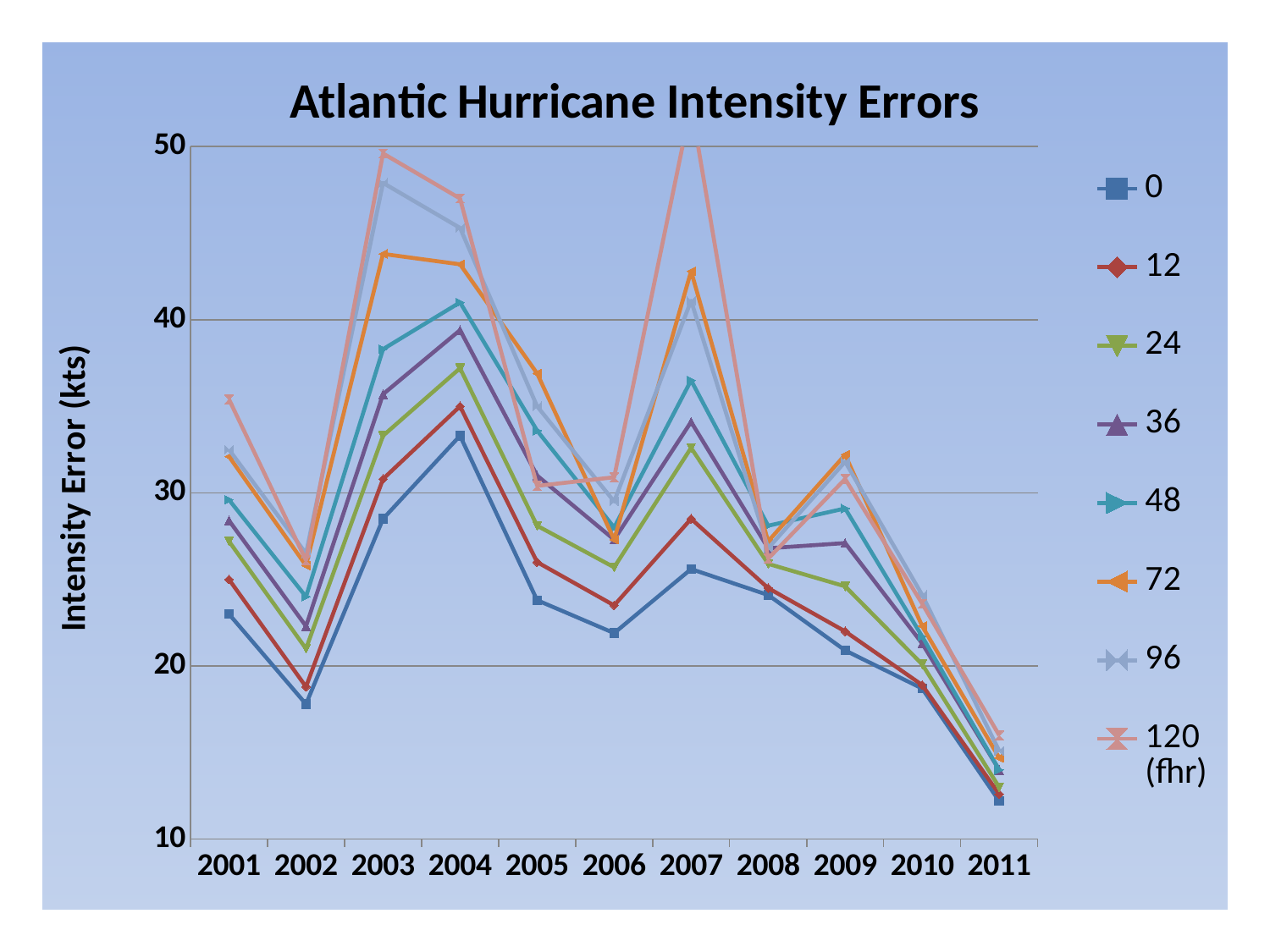
Does the 0 series rise or fall from 2009 to 2011? fall What kind of chart is shown on the slide? line chart In which year does the 0 series reach its lowest value? 2011 What is the label on the y axis? Intensity Error (kts) For the 48 series, is the value in 2003 larger or the value in 2002? 2003 In which year does the 0 series reach its highest value? 2004 How many series does the legend list? 8 Is the value for the 0 series in 2011 greater or less than 20? less How many years are shown along the x axis? 11 What is the title of the chart? Atlantic Hurricane Intensity Errors Is the value for the 120 (fhr) series in 2003 greater or less than 40? greater Is the value for the 0 series in 2004 greater or less than 30? greater